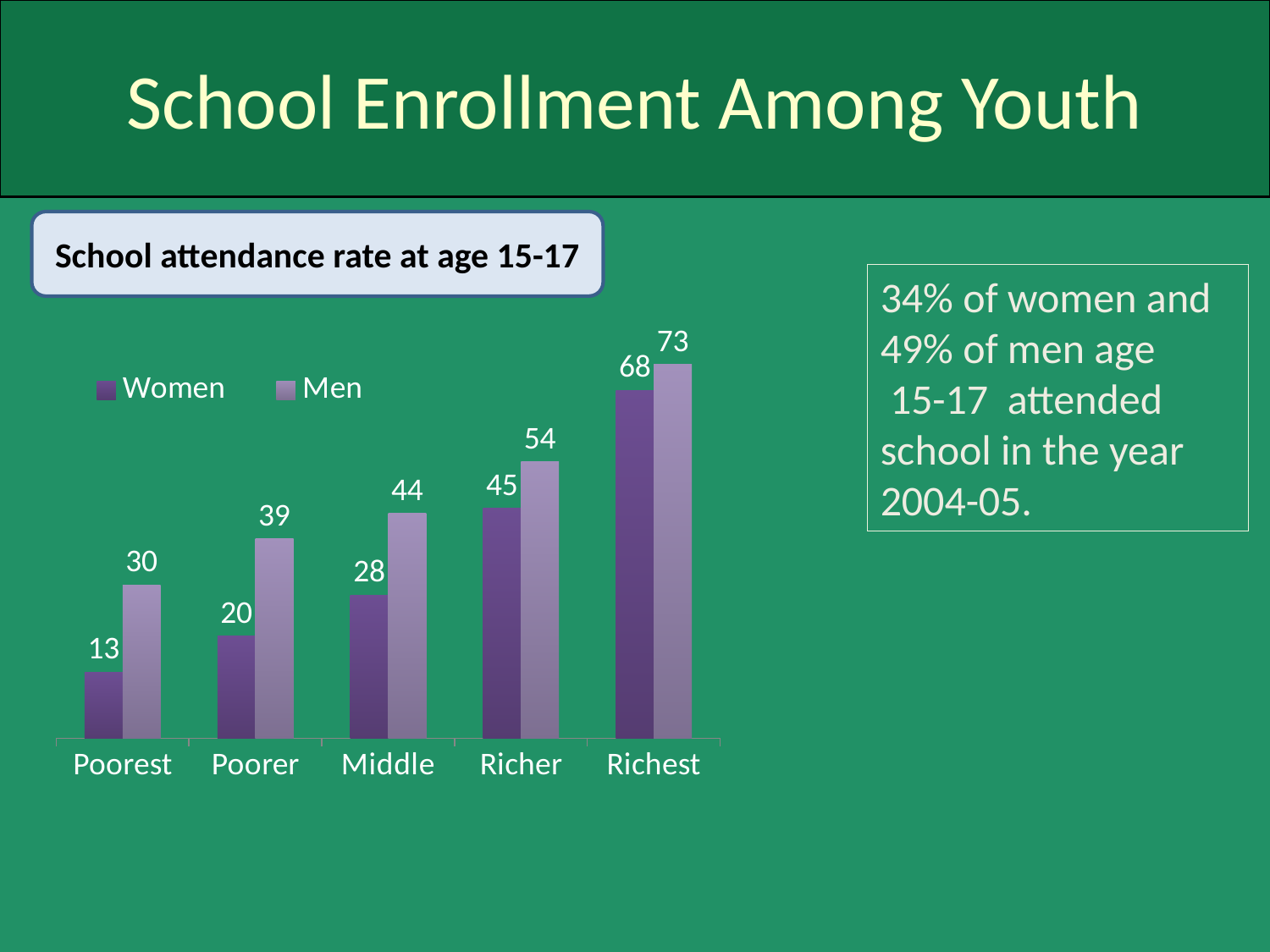
How many wealth groups are shown on the x axis? 5 How many series does the legend list? 2 What is the difference between the Men and Women values in the Poorer group? 19 Do the Women values rise or fall from Poorest to Richest? Rise What is the difference between the Richest and Poorest values for Women? 55 What is the value for Men in the Middle group? 44 Which is larger in the Richest group, the value for Women or for Men? Men Which wealth group has the highest attendance rate for Women? Richest Which wealth group has the lowest attendance rate for Men? Poorest What kind of chart is shown on the slide? Bar chart What is the school attendance rate for Women in the Poorest group? 13 What is the school attendance rate for Men in the Richer group? 54